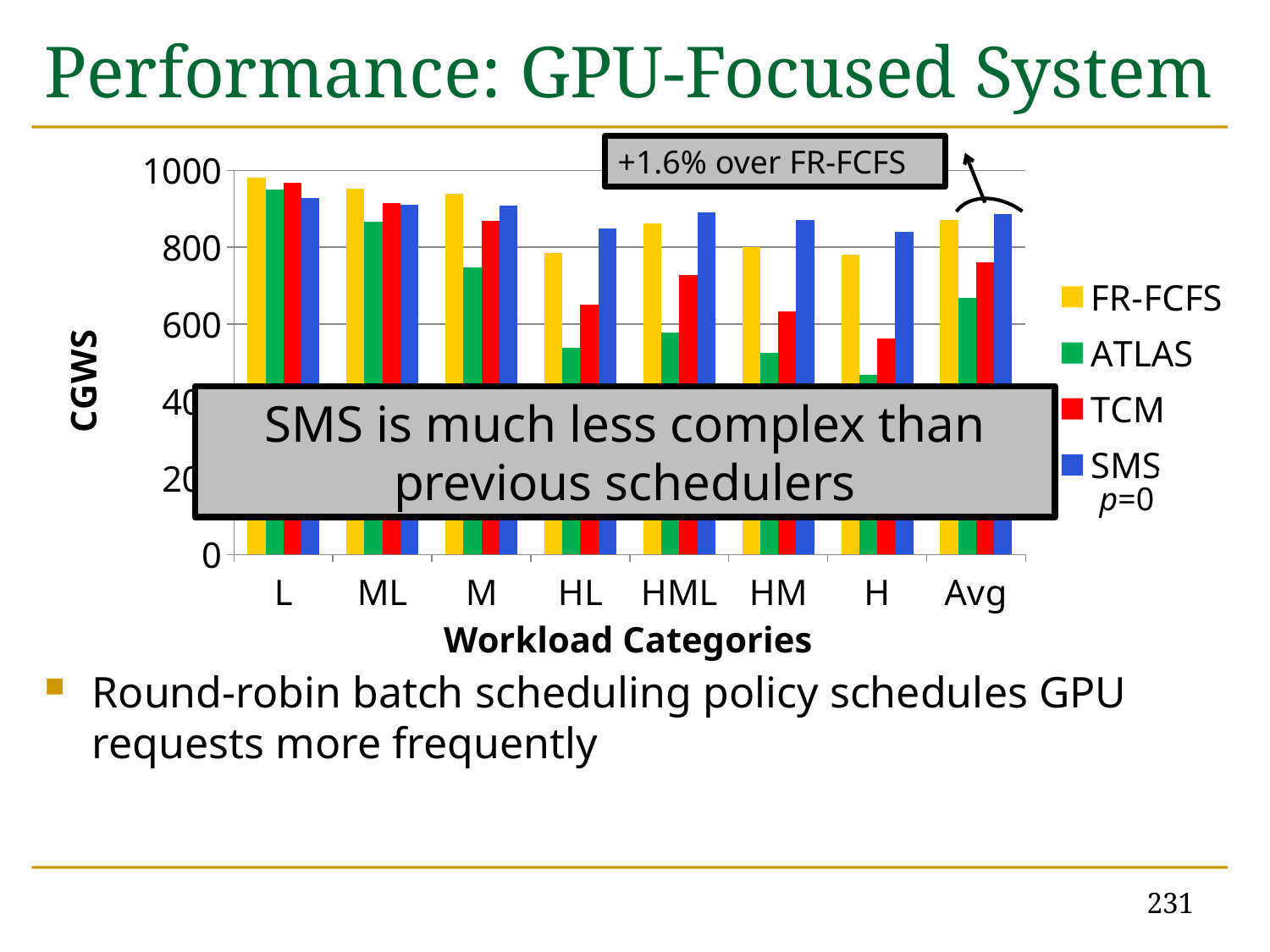
Is the SMS value for the HML workload category greater or less than 800? greater What kind of chart is shown on the slide? bar chart Is the ATLAS value for the HL workload category greater or less than 600? less According to the annotation on the chart, by how much does SMS improve over FR-FCFS? +1.6% Which scheduler has the highest CGWS for the HL workload category? SMS For the HM workload category, which is larger: the ATLAS value or the SMS value? SMS What is the label of the y axis? CGWS How many workload categories are shown on the x axis? 8 Is the ATLAS value for the H workload category greater or less than 600? less Which scheduler has the lowest CGWS for the H workload category? ATLAS How many series does the legend list? 4